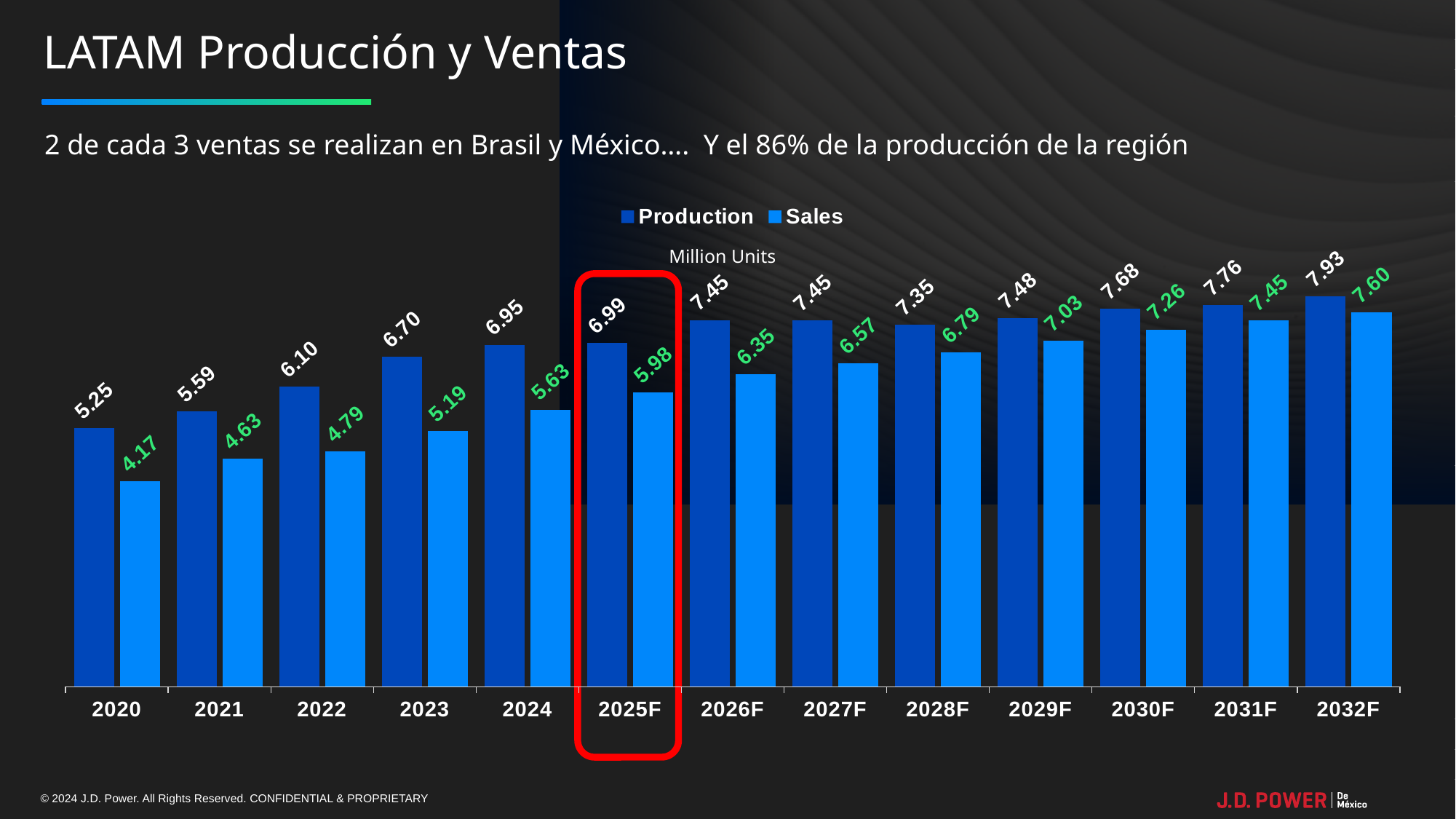
What is the Sales value for 2029F? 7.03 How many series does the legend list? 2 What is the difference between Production and Sales in 2024? 1.32 Which is larger in 2032F, Production or Sales? Production What is the Sales value for 2020? 4.17 Do the Sales values rise or fall from 2020 to 2032F? Rise Which year has the lowest Sales value? 2020 Which year has the highest Production value? 2032F What is the Production value for 2025F? 6.99 How many years are shown on the x axis? 13 What unit is stated for the chart values? Million Units What kind of chart is shown on the slide? Bar chart